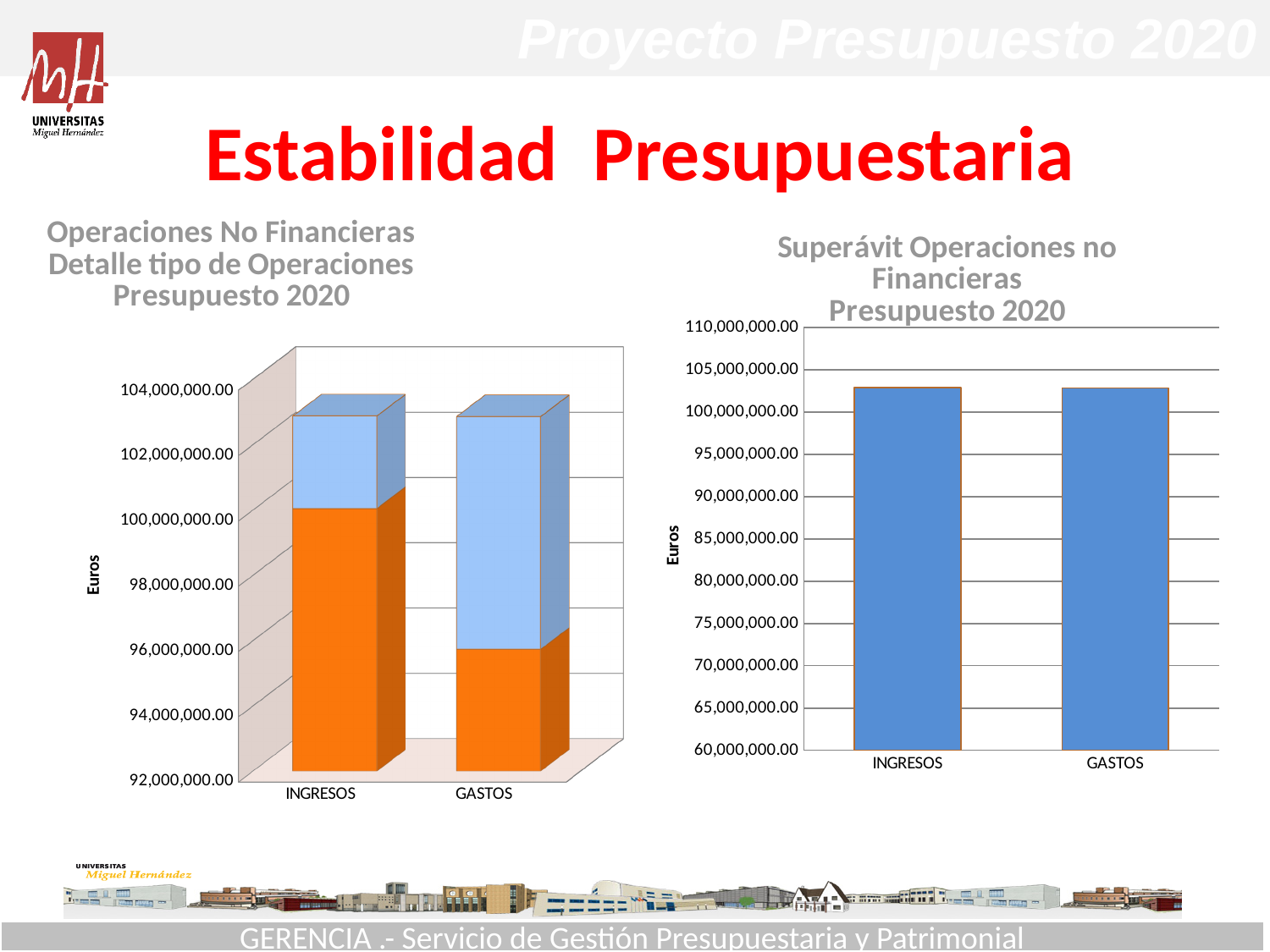
What is the label on the vertical axis of the chart on the right? Euros What is the title of the chart on the right? Superávit Operaciones no Financieras Presupuesto 2020 In the chart on the left, is the orange segment of the GASTOS bar greater or less than 98,000,000.00? less How many categories are shown on the x axis of the chart on the left? 2 In the chart on the left, is the total height of the INGRESOS bar greater or less than 102,000,000.00? greater In the chart on the right, is the value for INGRESOS greater or less than 100,000,000.00? greater What kind of chart is the chart titled 'Operaciones No Financieras Detalle tipo de Operaciones Presupuesto 2020'? stacked bar chart In the chart on the left, which category has the larger light blue segment, INGRESOS or GASTOS? GASTOS In the chart on the left, which category has the larger orange segment, INGRESOS or GASTOS? INGRESOS What kind of chart is the chart titled 'Superávit Operaciones no Financieras Presupuesto 2020'? bar chart How many categories are shown on the x axis of the chart on the right? 2